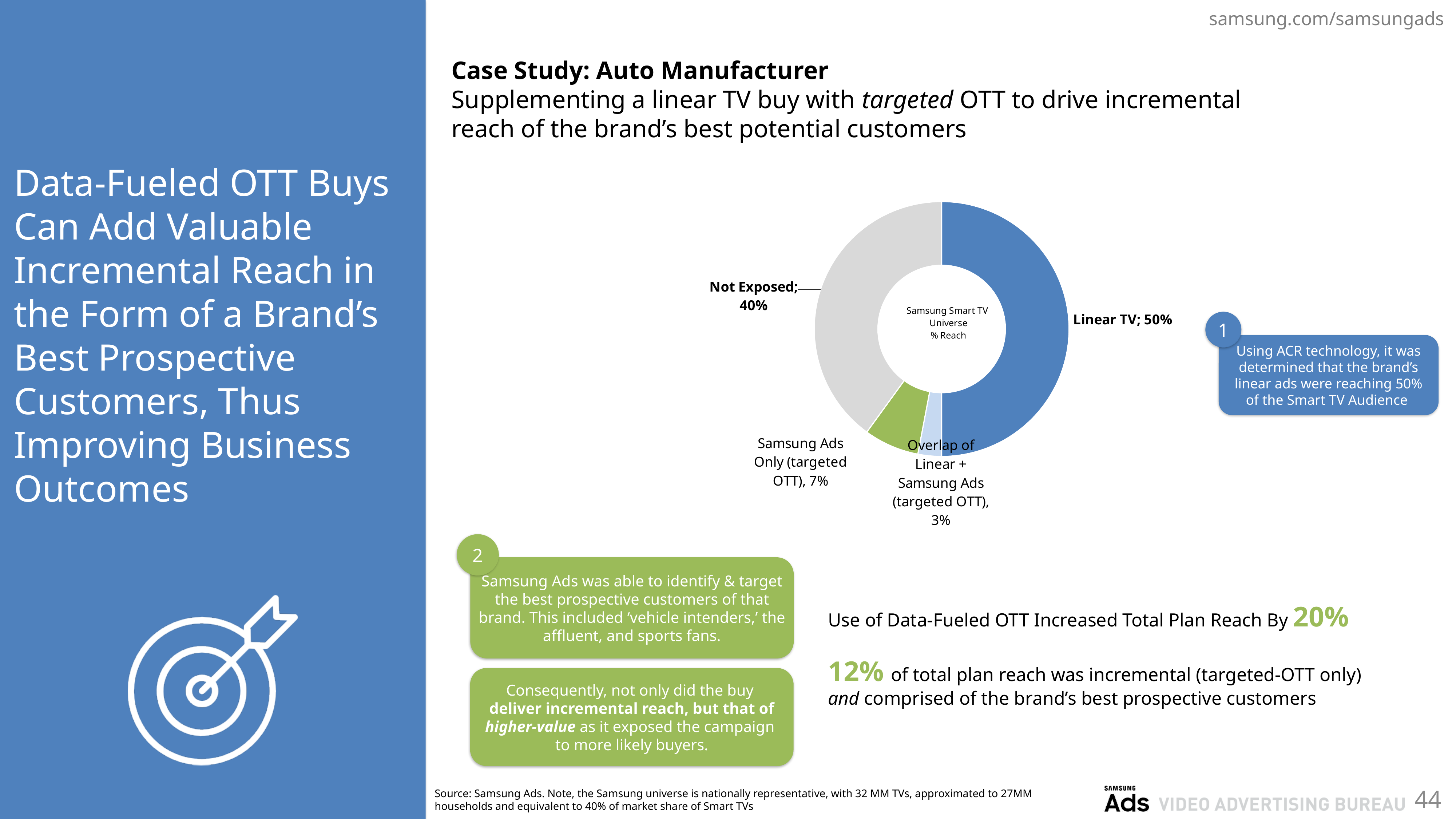
What is the value for Not Exposed? 40% What is the combined value of Samsung Ads Only (targeted OTT) and Overlap of Linear + Samsung Ads (targeted OTT)? 10% What is the difference between the Linear TV and Not Exposed values? 10% How many categories are shown in the chart? 4 What is the value for Overlap of Linear + Samsung Ads (targeted OTT)? 3% What is the value for Samsung Ads Only (targeted OTT)? 7% What is the value for Linear TV? 50% Which category has the smallest share of the chart? Overlap of Linear + Samsung Ads (targeted OTT) What type of chart is shown on the slide? Doughnut chart Which category has the largest share of the chart? Linear TV What text appears in the centre of the doughnut chart? Samsung Smart TV Universe % Reach Which is larger, Samsung Ads Only (targeted OTT) or Overlap of Linear + Samsung Ads (targeted OTT)? Samsung Ads Only (targeted OTT)